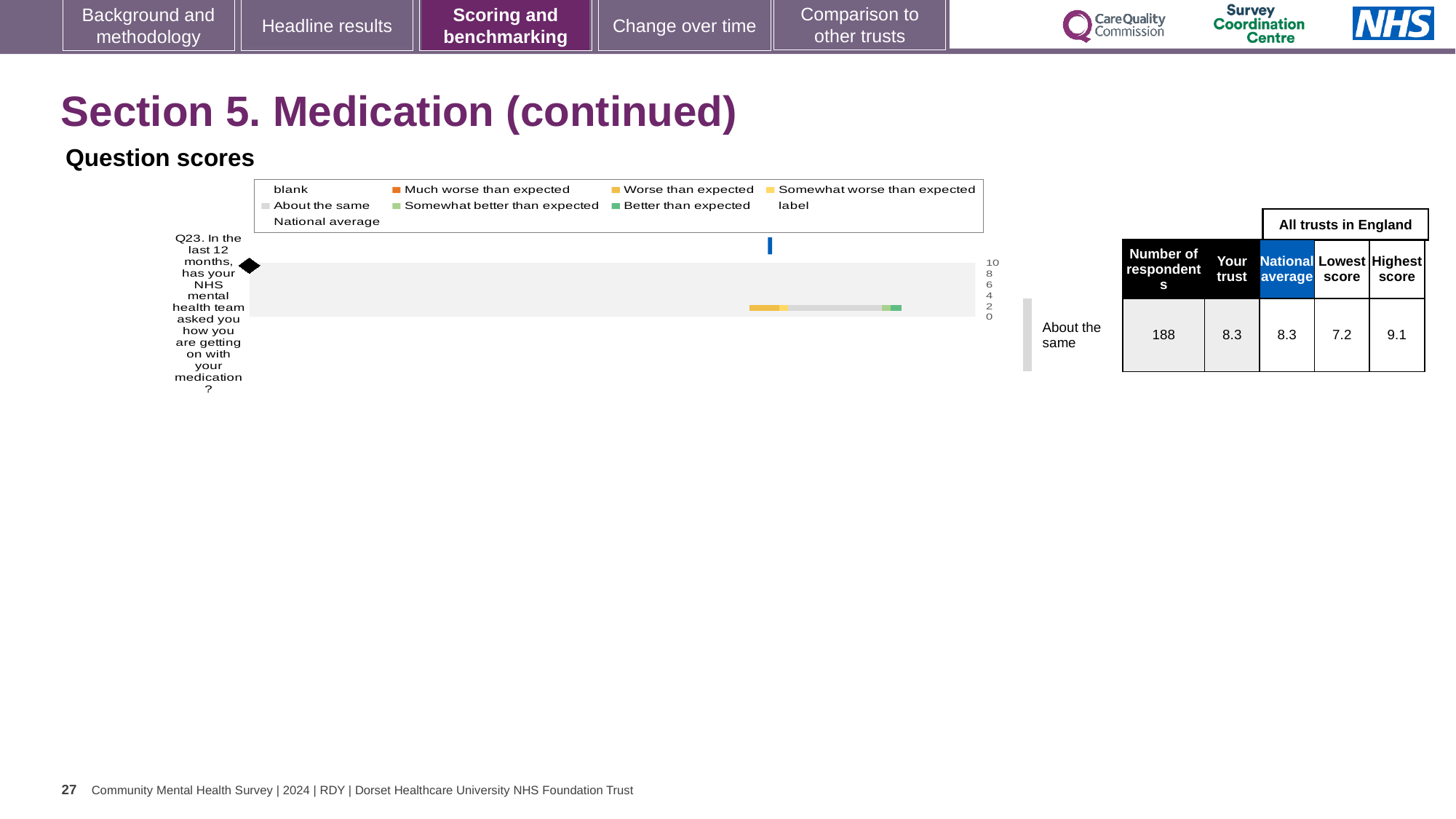
What is the highest score among all trusts in England for Q23? 9.1 What is the 'Your trust' score for Q23? 8.3 Is the trust's score for Q23 higher or lower than the national average, or the same? the same Which benchmarking category is the trust's Q23 score placed in? About the same What is the national average score for Q23? 8.3 How many survey questions are plotted on the chart? 1 What is the lowest score among all trusts in England for Q23? 7.2 How many respondents answered Q23? 188 Which question is plotted on the chart? Q23. In the last 12 months, has your NHS mental health team asked you how you are getting on with your medication? Is the trust's score for Q23 greater or less than 6? greater What kind of chart is used to show the Q23 question score? bar chart What is the difference between the highest score and the lowest score for Q23? 1.9